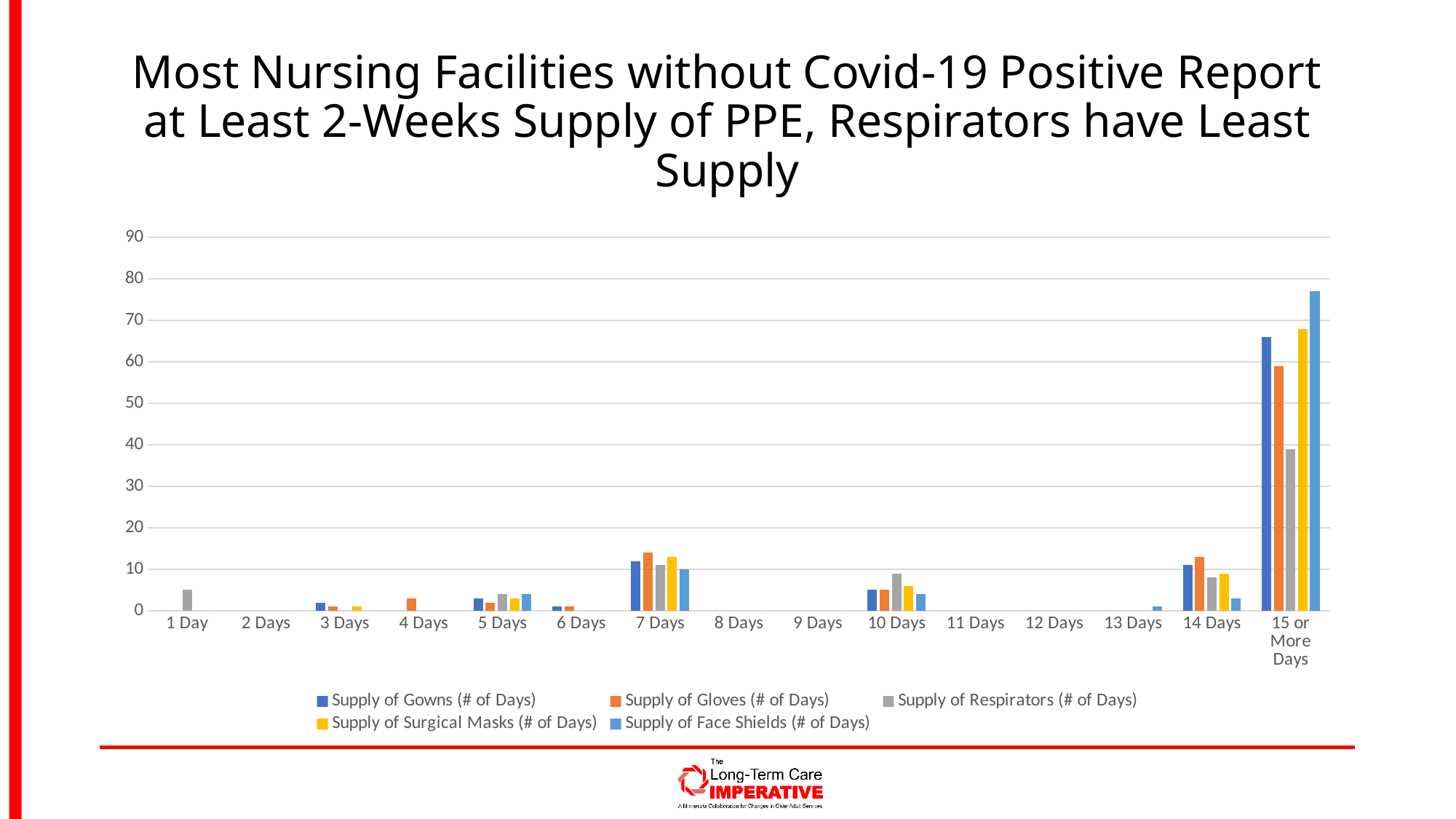
How many categories are shown along the x axis? 15 At 15 or More Days, which is larger: Supply of Gowns or Supply of Gloves? Supply of Gowns (# of Days) In the 15 or More Days category, which series has the highest value? Supply of Face Shields (# of Days) What kind of chart is shown on the slide? Bar chart In the 15 or More Days category, which series has the lowest value? Supply of Respirators (# of Days) Which category has the tallest bars overall? 15 or More Days Is the value for Supply of Respirators at 15 or More Days greater or less than 50? less Is the value for Supply of Face Shields at 15 or More Days greater or less than 70? greater How many series does the legend list? 5 At 10 Days, which is larger: Supply of Respirators or Supply of Face Shields? Supply of Respirators (# of Days) What colour represents Supply of Respirators (# of Days) in the legend? Gray Is the value for Supply of Gloves at 15 or More Days greater or less than 50? greater